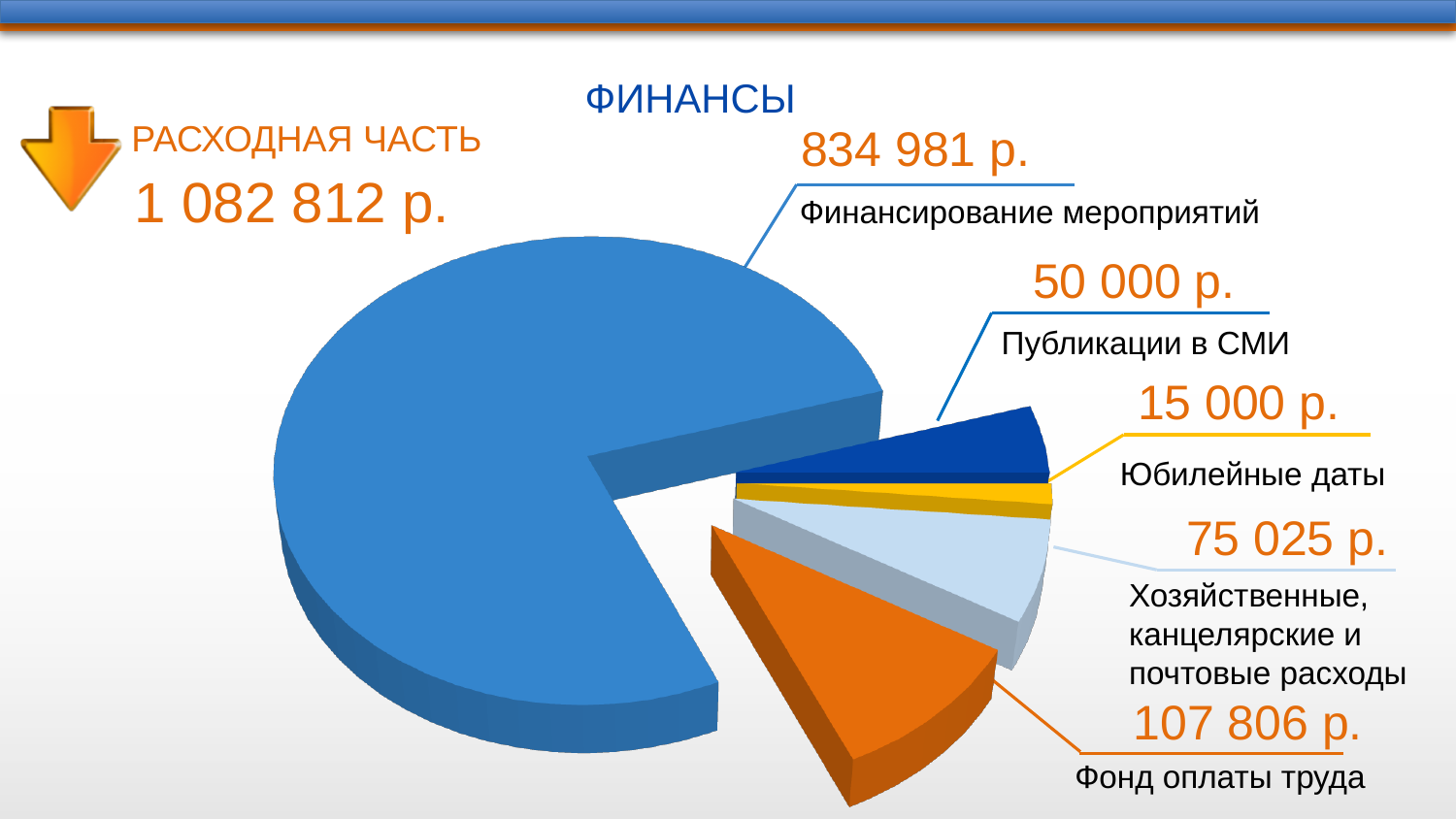
What is the value for Финансирование мероприятий? 834 981 р. What colour is the slice for Фонд оплаты труда? Orange What is the value for Юбилейные даты? 15 000 р. Which is larger: Публикации в СМИ or Фонд оплаты труда? Фонд оплаты труда What is the difference between Фонд оплаты труда and Хозяйственные, канцелярские и почтовые расходы? 32 781 р. How many slices does the pie chart have? 5 What type of chart is shown on the slide? Pie chart Which category has the largest slice of the pie? Финансирование мероприятий What is the value for Публикации в СМИ? 50 000 р. What is the value for Фонд оплаты труда? 107 806 р. Which category has the smallest slice of the pie? Юбилейные даты What is the value for Хозяйственные, канцелярские и почтовые расходы? 75 025 р.